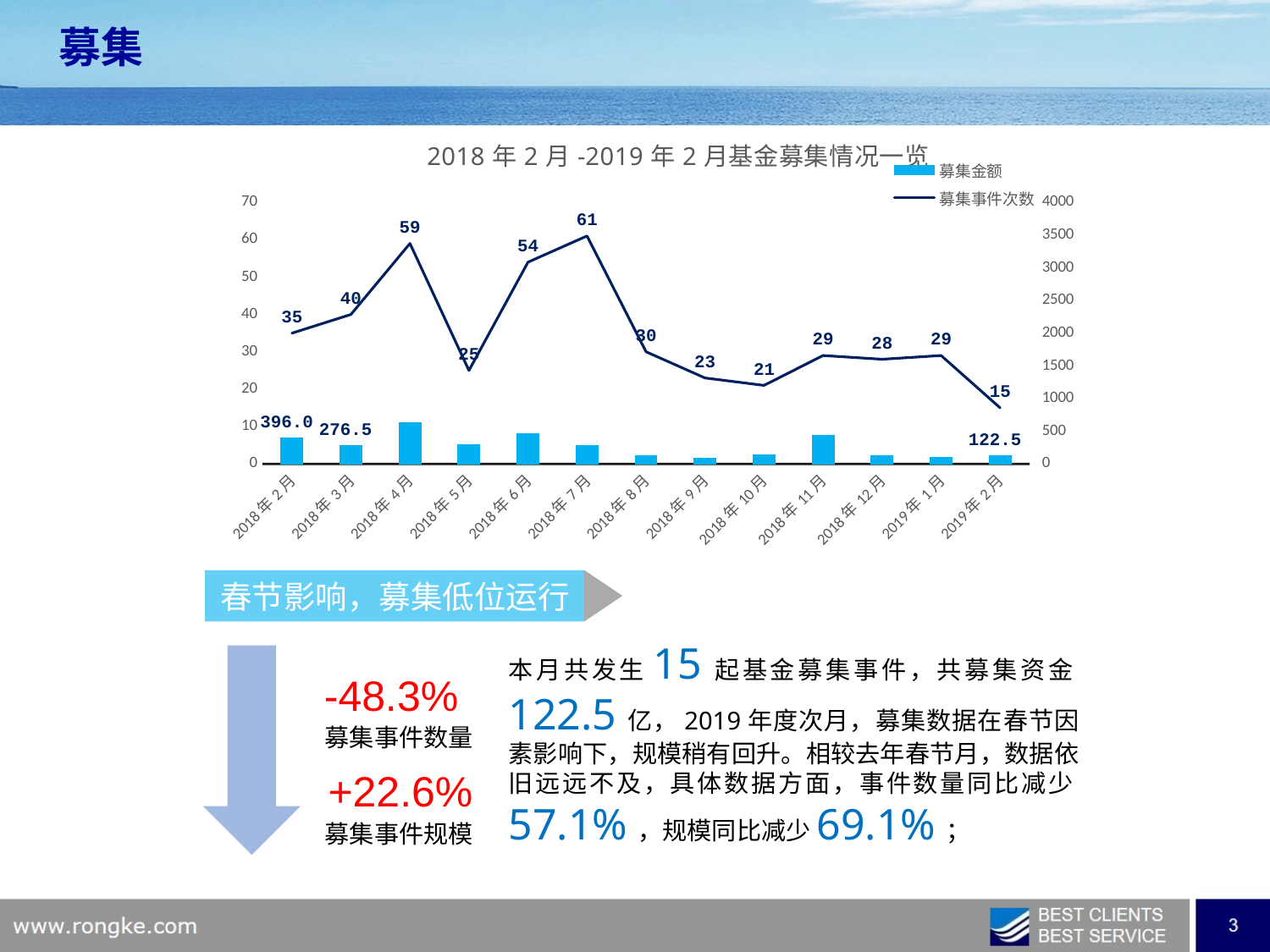
Is the 募集金额 bar for 2018年9月 greater or less than 500? less What is the 募集事件次数 value for 2018年7月? 61 How many series does the legend list? 2 What is the 募集金额 value for 2019年2月? 122.5 Does the 募集事件次数 rise or fall from 2018年8月 to 2018年10月? Fall Which month has the highest 募集事件次数? 2018年7月 What kind of chart is this? Combination bar and line chart Which month has the lowest 募集事件次数? 2019年2月 Which month has a larger 募集事件次数, 2018年6月 or 2018年8月? 2018年6月 What is the difference in 募集事件次数 between 2018年4月 and 2018年5月? 34 How many months are shown on the x axis? 13 What is the difference in 募集金额 between 2018年2月 and 2018年3月? 119.5